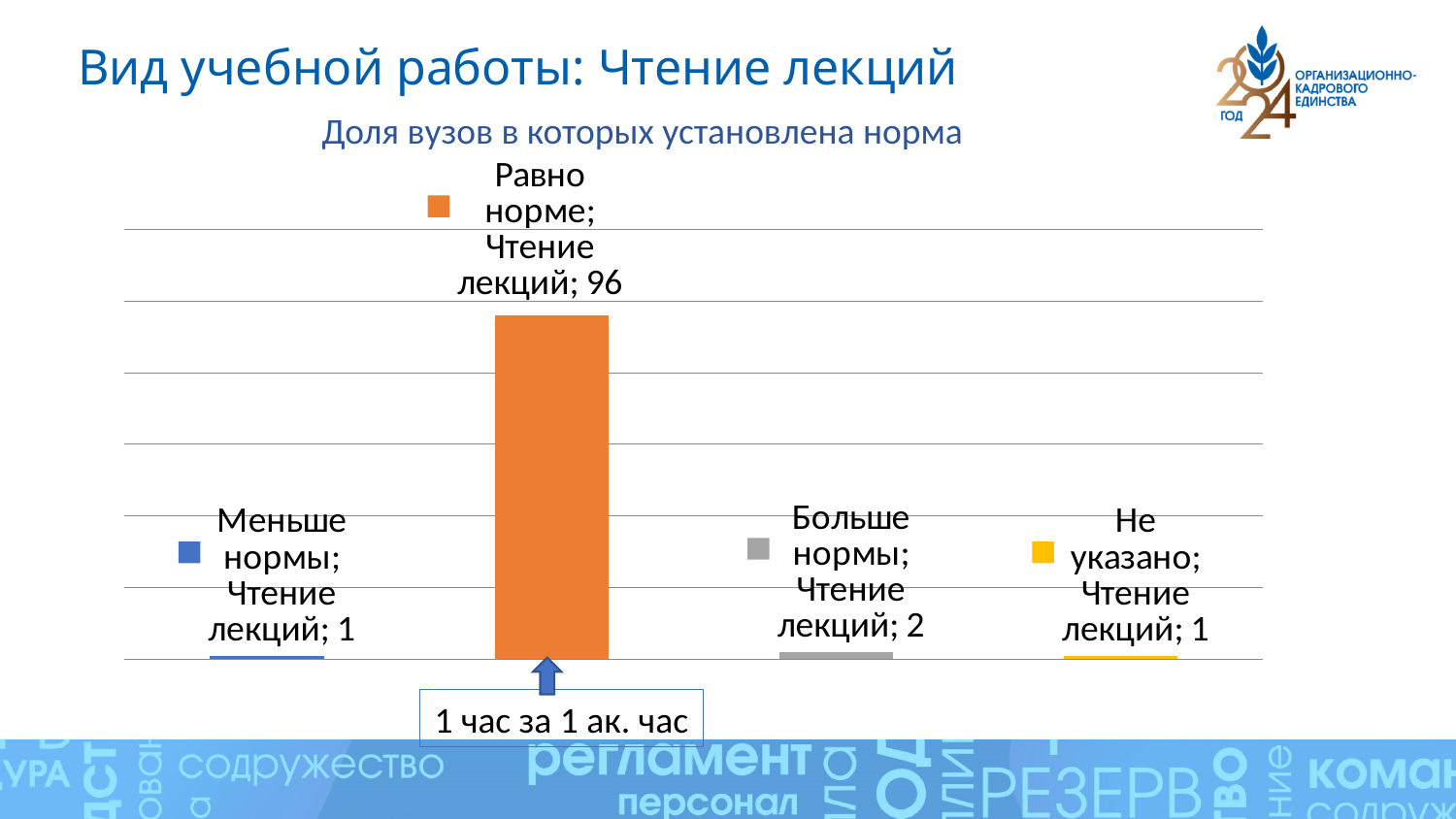
What is the value for "Меньше нормы" in the chart? 1 What is the value for "Больше нормы" in the chart? 2 What is the value for "Не указано" in the chart? 1 How many categories are shown in the chart? 4 What is the title of the chart? Доля вузов в которых установлена норма What is the value for "Равно норме" in the chart? 96 What kind of chart is shown on the slide? Bar chart What colour is the bar for "Равно норме"? Orange Which is larger, the value for "Больше нормы" or the value for "Меньше нормы"? Больше нормы Which category has the highest value in the chart? Равно норме What is the difference between the values for "Равно норме" and "Больше нормы"? 94 What is the total of all four values in the chart? 100